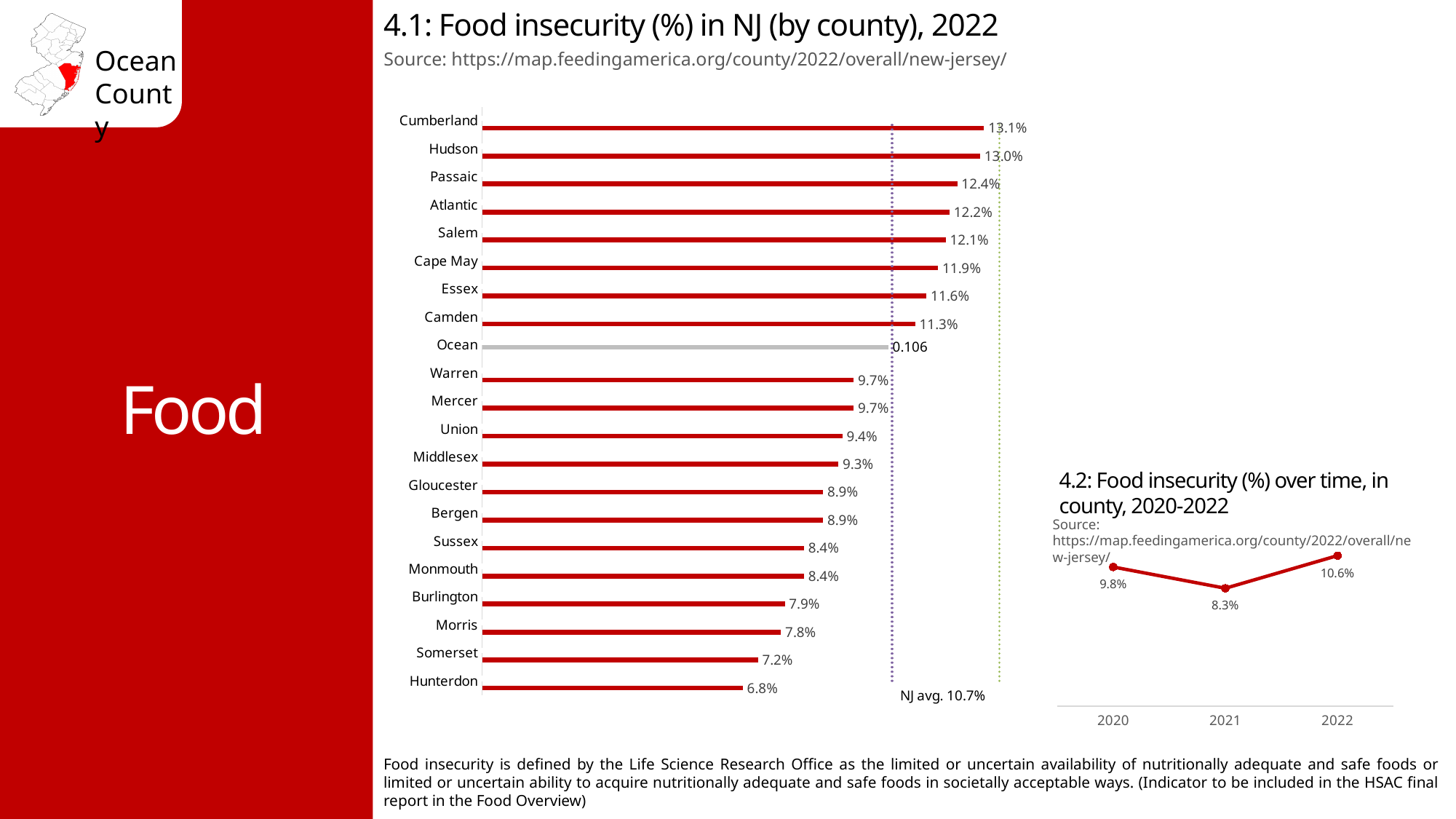
In chart 4.2 (Food insecurity over time in county, 2020-2022), what is the difference between 2022 and 2021? 2.3% In chart 4.1 (Food insecurity in NJ by county, 2022), what is the value for Cumberland? 13.1% In chart 4.1 (Food insecurity in NJ by county, 2022), which county has the highest food insecurity? Cumberland In chart 4.1 (Food insecurity in NJ by county, 2022), which county has the lowest food insecurity? Hunterdon In chart 4.1 (Food insecurity in NJ by county, 2022), what is the value for Hunterdon? 6.8% In chart 4.1 (Food insecurity in NJ by county, 2022), what is the NJ average shown by the dotted line? 10.7% In chart 4.1 (Food insecurity in NJ by county, 2022), what is the difference between Cumberland and Hunterdon? 6.3% What kind of chart is chart 4.2 (Food insecurity over time in county, 2020-2022)? Line chart In chart 4.1 (Food insecurity in NJ by county, 2022), which is higher, Essex or Camden? Essex In chart 4.1 (Food insecurity in NJ by county, 2022), how many counties are shown? 21 In chart 4.2 (Food insecurity over time in county, 2020-2022), what is the value for 2021? 8.3% What kind of chart is chart 4.1 (Food insecurity in NJ by county, 2022)? Bar chart